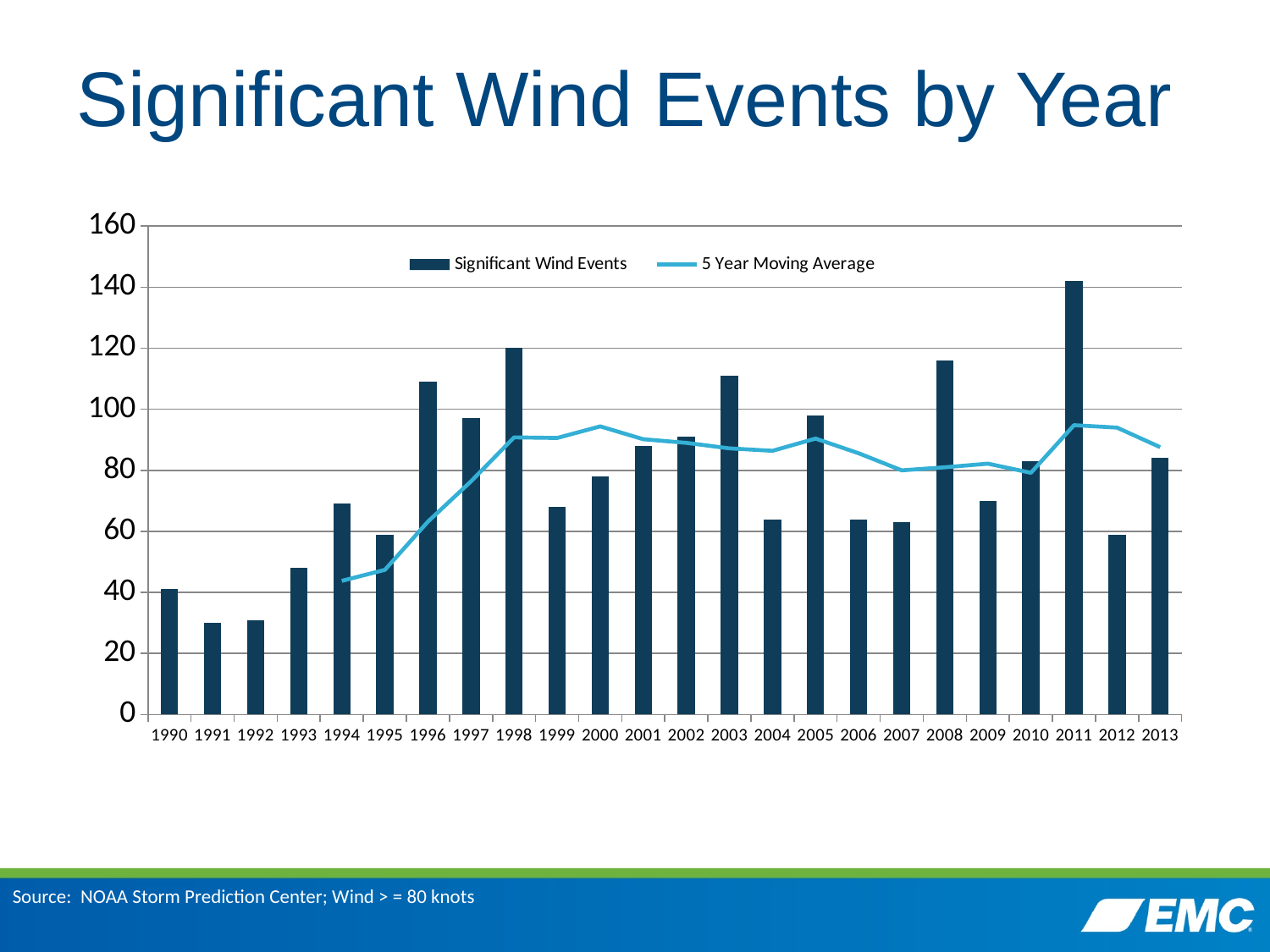
Which year has more Significant Wind Events, 2003 or 2004? 2003 Is the value for Significant Wind Events in 1990 greater or less than 60? less What is the title of the chart? Significant Wind Events by Year Which year has more Significant Wind Events, 1996 or 1997? 1996 What kind of chart is shown on the slide? bar chart with a line Is the value for Significant Wind Events in 2011 greater or less than 120? greater How many years are shown on the x axis of the chart? 24 Is the value for Significant Wind Events in 2008 greater or less than 100? greater How many series does the legend list? 2 Do the Significant Wind Events rise or fall from 1991 to 1994? rise Which year has the highest number of Significant Wind Events? 2011